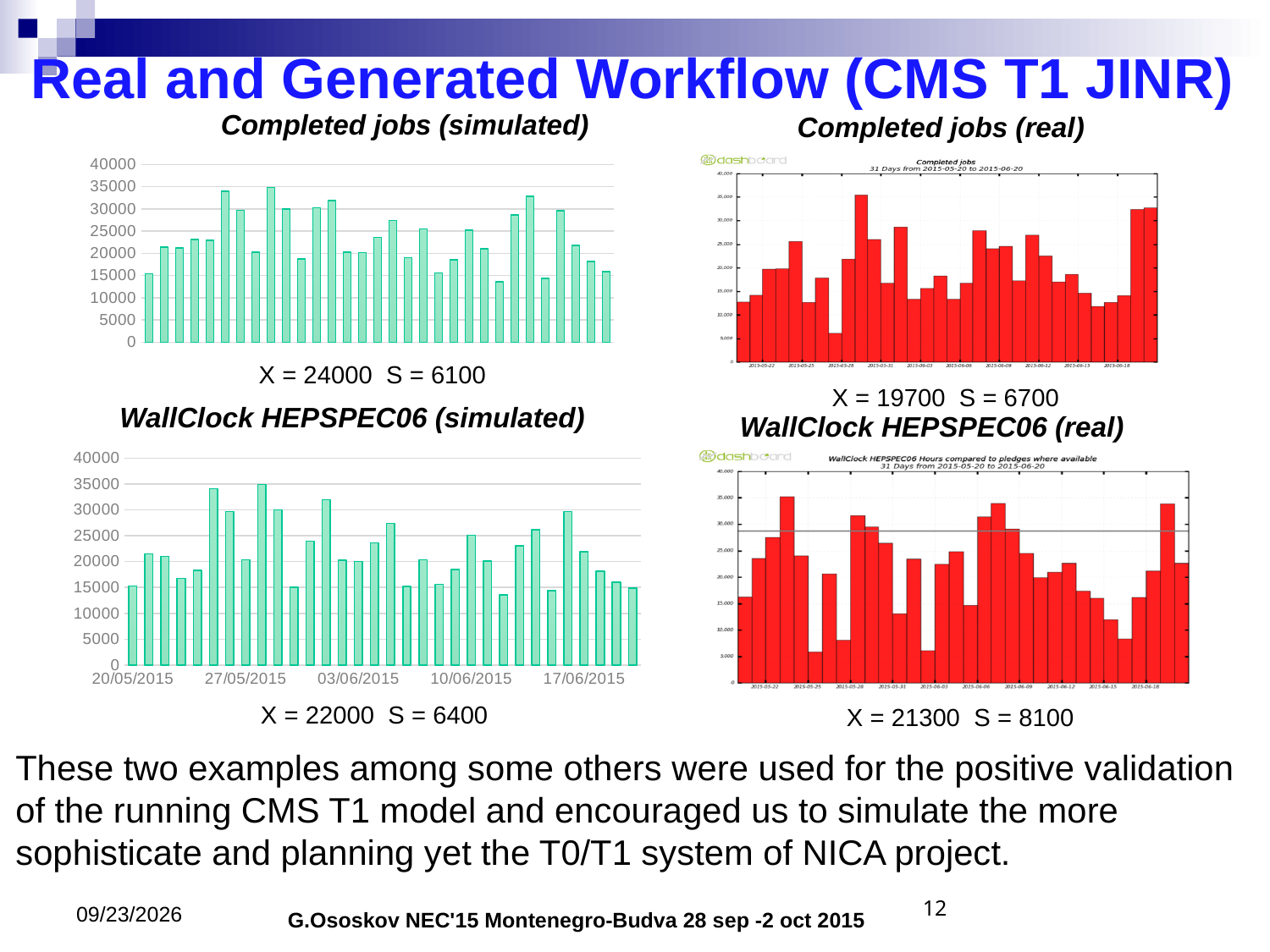
In the Completed jobs (real) chart, is the tallest bar greater or less than 30000? greater What kind of chart is the WallClock HEPSPEC06 (real) chart? bar chart In the WallClock HEPSPEC06 (simulated) chart, is the bar at 20/05/2015 greater or less than 20000? less In the Completed jobs (simulated) chart, is the tallest bar greater or less than 30000? greater What kind of chart is the Completed jobs (simulated) chart? bar chart What is the first date label on the x axis of the WallClock HEPSPEC06 (simulated) chart? 20/05/2015 What is the highest value shown on the y axis of the Completed jobs (simulated) chart? 40000